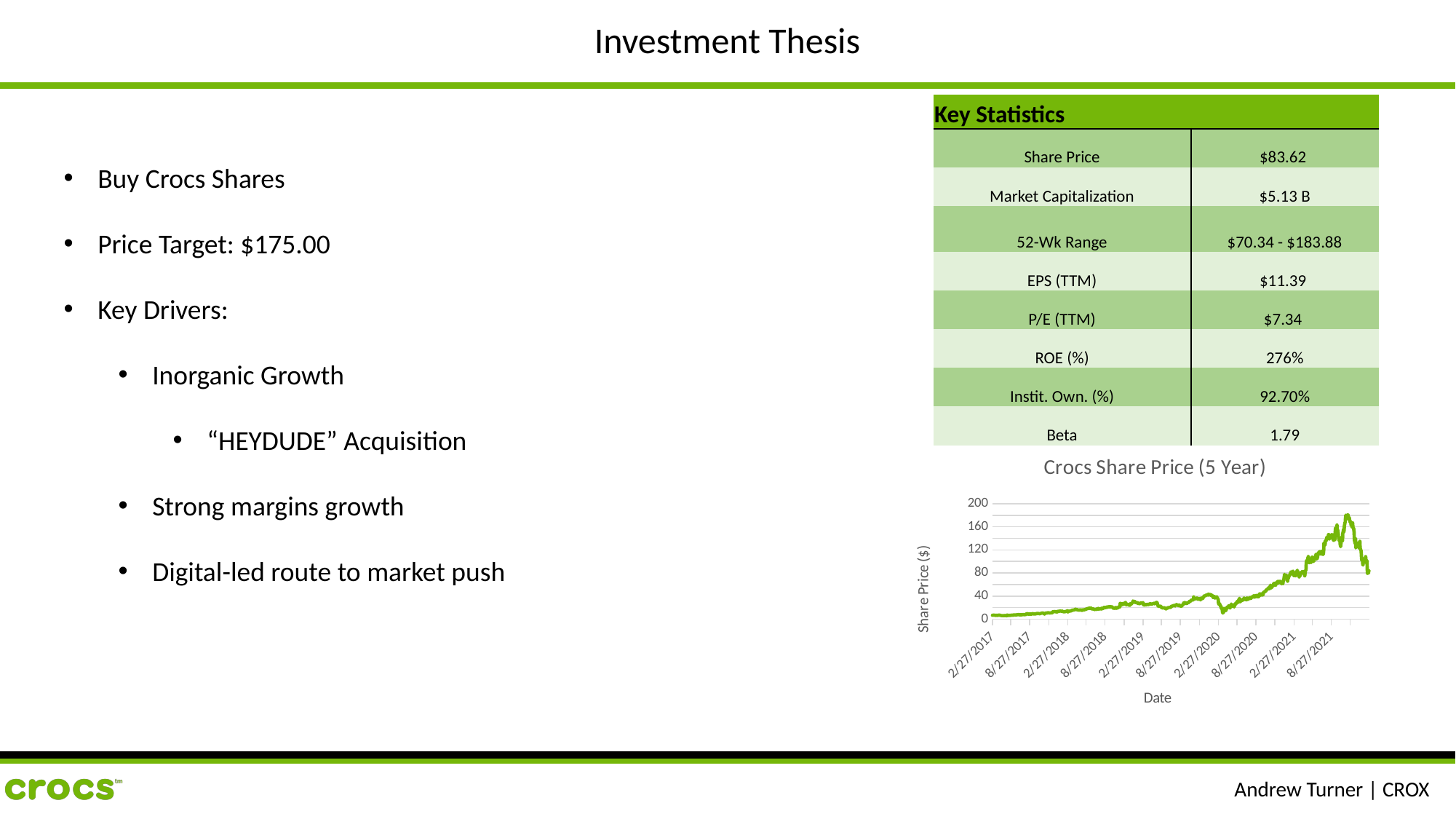
On the Crocs Share Price (5 Year) chart, is the share price at 2/27/2017 greater or less than 40? less What kind of chart is the Crocs Share Price (5 Year) chart? line chart How many date labels are shown on the x axis of the Crocs Share Price (5 Year) chart? 10 On the Crocs Share Price (5 Year) chart, is the share price higher at 2/27/2021 or at 2/27/2018? 2/27/2021 What is the label of the vertical axis on the Crocs Share Price (5 Year) chart? Share Price ($) What is the highest value shown on the vertical axis of the Crocs Share Price (5 Year) chart? 200 On the Crocs Share Price (5 Year) chart, is the share price at 2/27/2019 greater or less than 80? less On the Crocs Share Price (5 Year) chart, is the share price at 8/27/2021 greater or less than 120? greater Overall, does the share price rise or fall from 2/27/2017 to 8/27/2021 on the Crocs Share Price (5 Year) chart? rise What is the title of the chart on the slide? Crocs Share Price (5 Year)